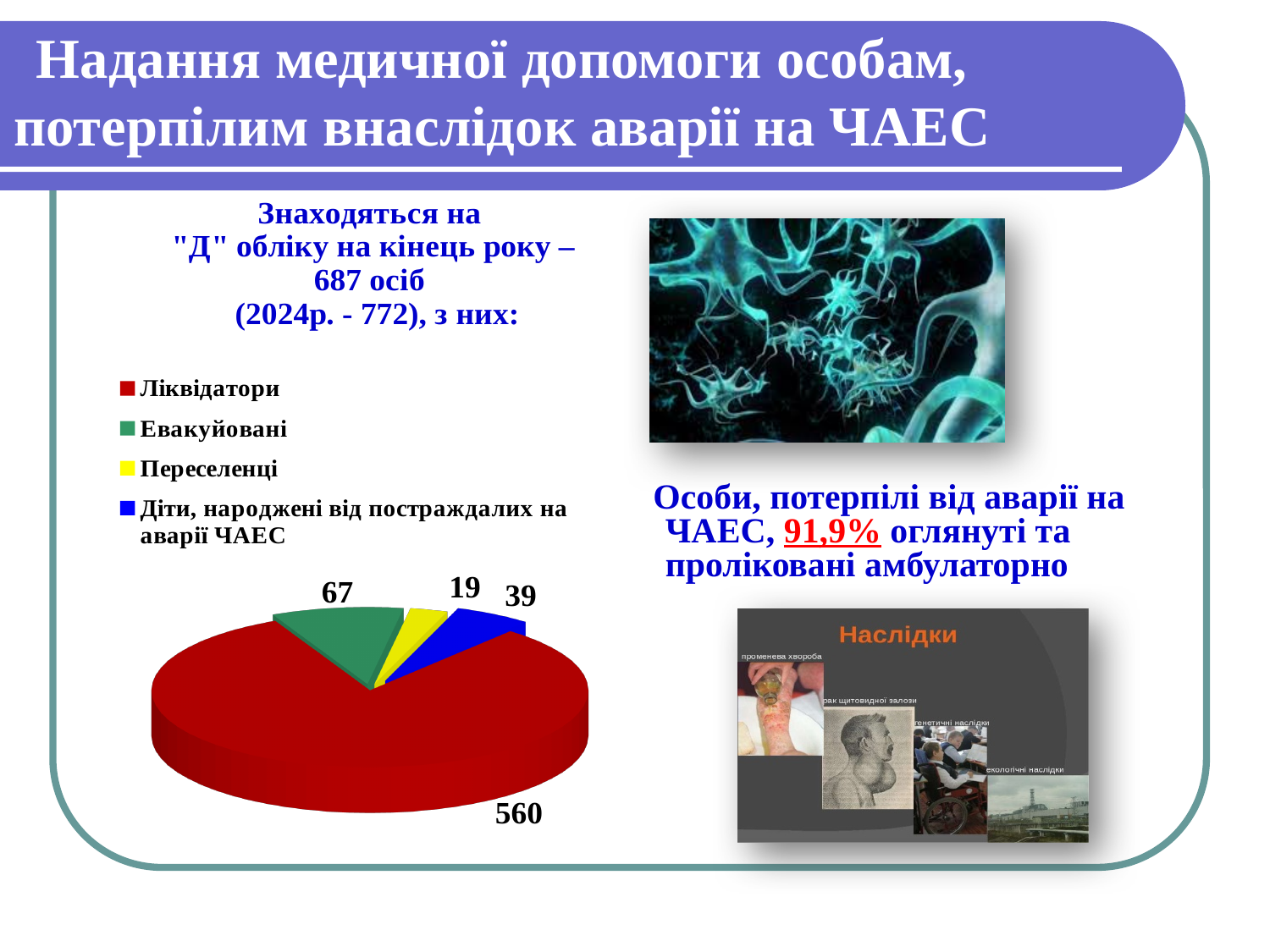
What kind of chart is shown on the slide? pie chart What colour is the slice for Переселенці in the pie chart? yellow What is the value for Евакуйовані in the pie chart? 67 Which category has the smallest slice in the pie chart? Переселенці Which is larger, the value for Евакуйовані or the value for Діти, народжені від постраждалих на аварії ЧАЕС? Евакуйовані What is the value for Діти, народжені від постраждалих на аварії ЧАЕС in the pie chart? 39 What is the value for Ліквідатори in the pie chart? 560 Which category has the largest slice in the pie chart? Ліквідатори What is the difference between the values for Ліквідатори and Евакуйовані? 493 What is the value for Переселенці in the pie chart? 19 How many slices does the pie chart have? 4 How many entries does the legend of the pie chart list? 4